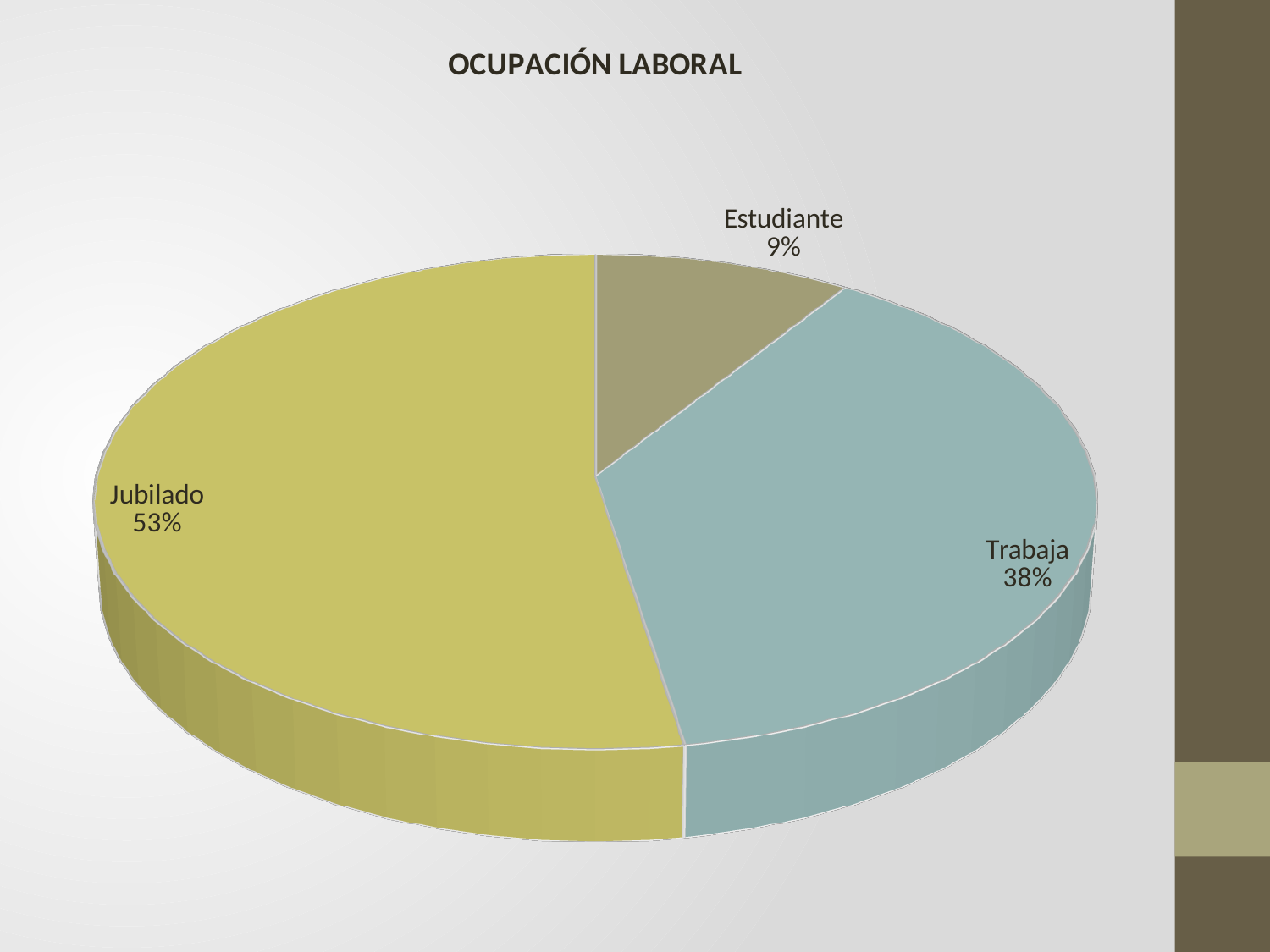
Which is larger, the share for Trabaja or the share for Estudiante? Trabaja Which category has the largest slice? Jubilado What kind of chart is shown on the slide? pie chart What is the difference in percentage points between Jubilado and Trabaja? 15% What is the difference in percentage points between Trabaja and Estudiante? 29% What share of the pie does Estudiante represent? 9% How many categories are shown in the pie chart? 3 What share of the pie does Jubilado represent? 53% What share of the pie does Trabaja represent? 38% Is the share for Jubilado greater or less than 50%? greater Which category has the smallest slice? Estudiante What is the title of the chart? OCUPACIÓN LABORAL